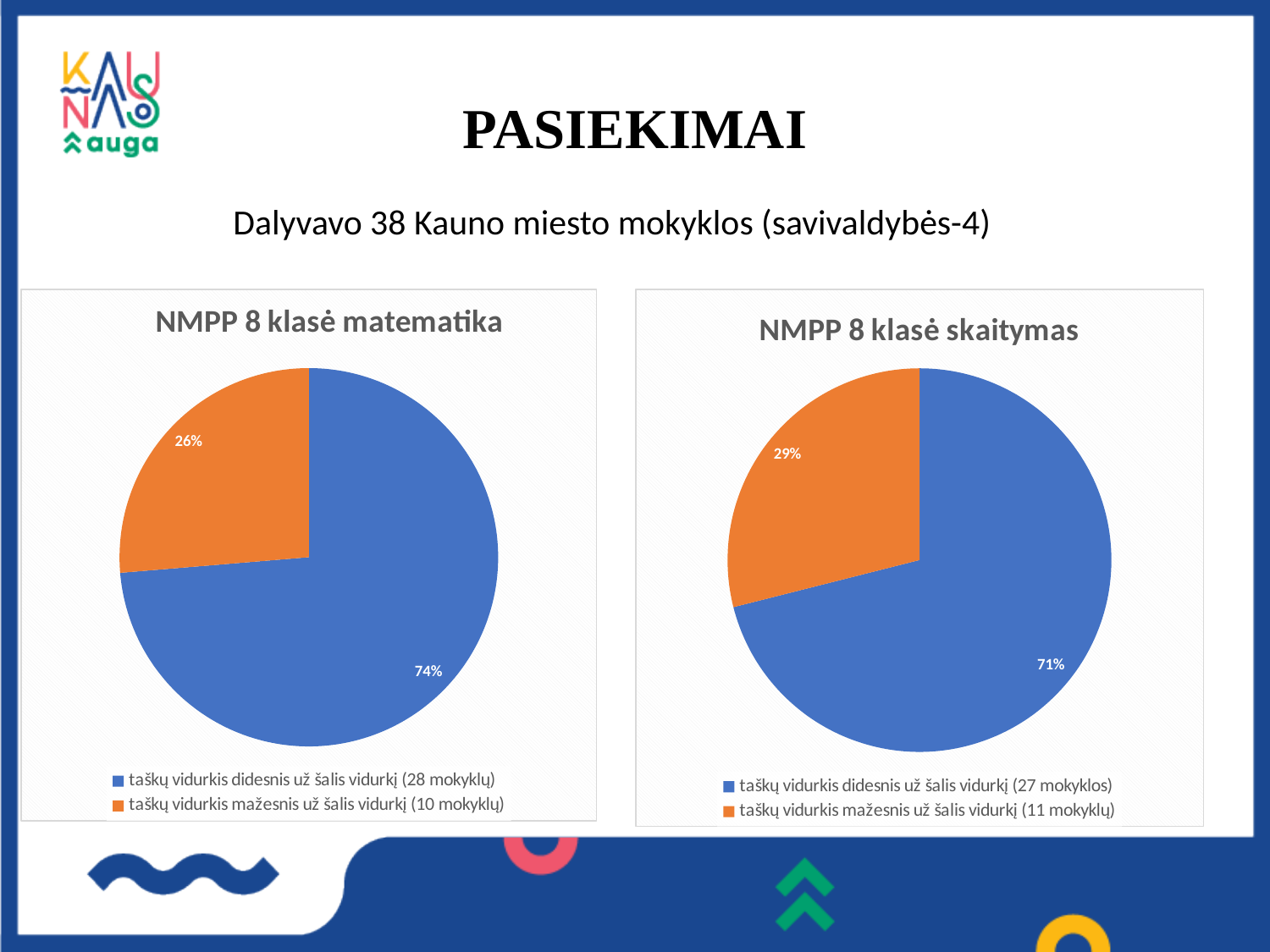
In the 'NMPP 8 klasė skaitymas' chart, which category has the smallest share? taškų vidurkis mažesnis už šalis vidurkį (11 mokyklų) In the 'NMPP 8 klasė skaitymas' chart, what percentage is shown for the orange slice (taškų vidurkis mažesnis už šalis vidurkį)? 29% In the 'NMPP 8 klasė matematika' chart, what percentage is shown for the orange slice (taškų vidurkis mažesnis už šalis vidurkį)? 26% According to the legend of the 'NMPP 8 klasė matematika' chart, how many schools had an average score lower than the national average? 10 mokyklų How many entries does the legend of the 'NMPP 8 klasė matematika' chart list? 2 In the 'NMPP 8 klasė matematika' chart, what is the difference in percentage points between the blue and orange slices? 48 percentage points What kind of chart is 'NMPP 8 klasė matematika'? Pie chart According to the legend of the 'NMPP 8 klasė skaitymas' chart, how many schools had an average score higher than the national average? 27 mokyklos In the 'NMPP 8 klasė skaitymas' chart, what share of the pie is labelled for schools whose average score is higher than the national average? 71% How many slices does the 'NMPP 8 klasė skaitymas' pie chart have? 2 In the 'NMPP 8 klasė matematika' chart, what share of the pie is labelled for schools whose average score is higher than the national average? 74% In the 'NMPP 8 klasė matematika' chart, which slice is larger: the blue one or the orange one? The blue one (74%)